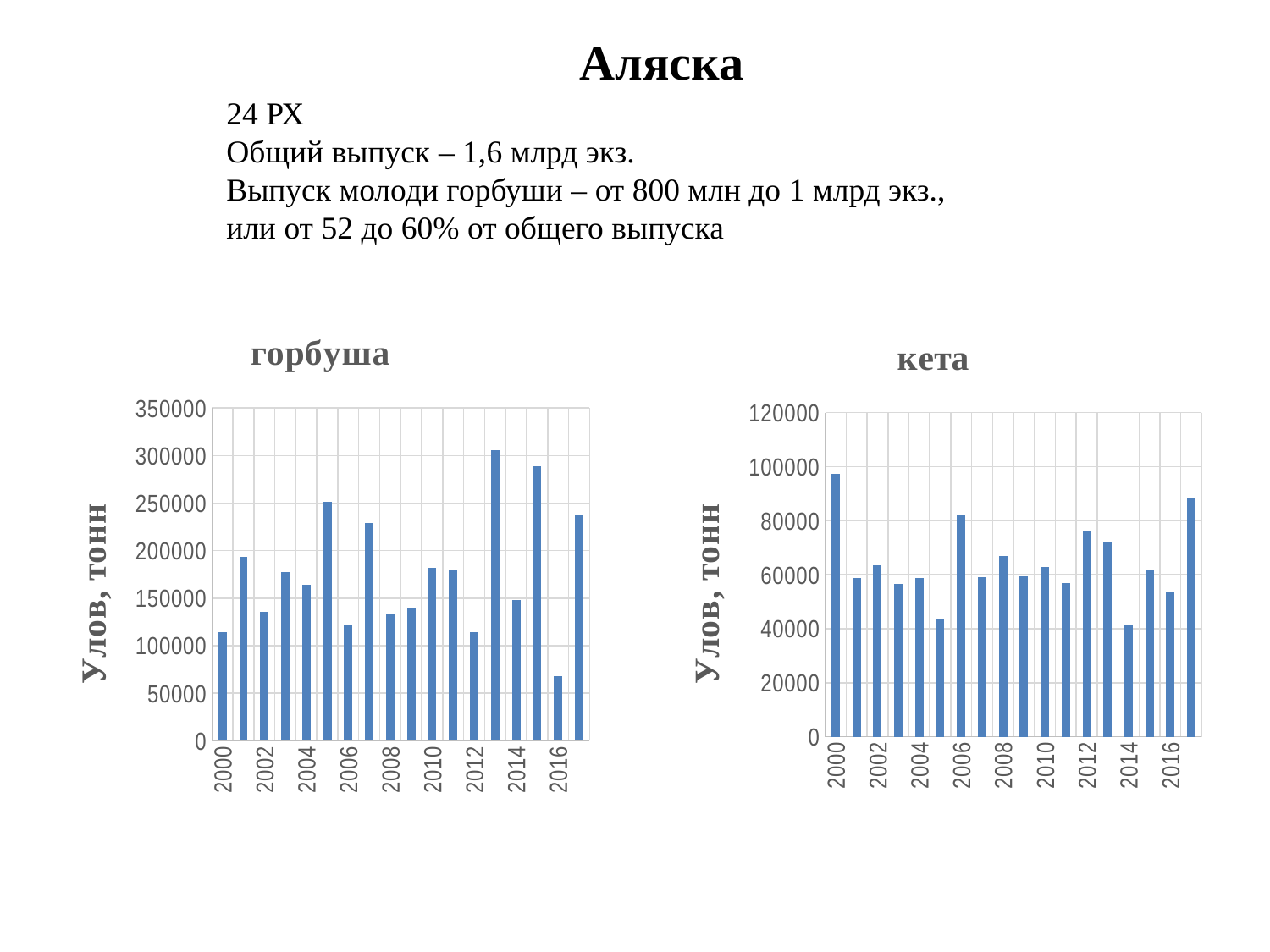
In the "горбуша" chart, is the value for 2016 greater or less than 100000? less How many bars (years) are plotted in the "кета" chart? 18 In the "кета" chart, is the value for 2005 greater or less than 50000? less In the "горбуша" chart, which year has the highest catch? 2013 What kind of chart is the "горбуша" chart? bar chart In the "кета" chart, which year has the highest catch? 2000 In the "горбуша" chart, which year has the larger catch, 2005 or 2007? 2005 In the "кета" chart, is the value for 2017 greater or less than 80000? greater What is the y-axis label on the "кета" chart? Улов, тонн In the "горбуша" chart, which year has the lowest catch? 2016 In the "кета" chart, which year has the lowest catch? 2014